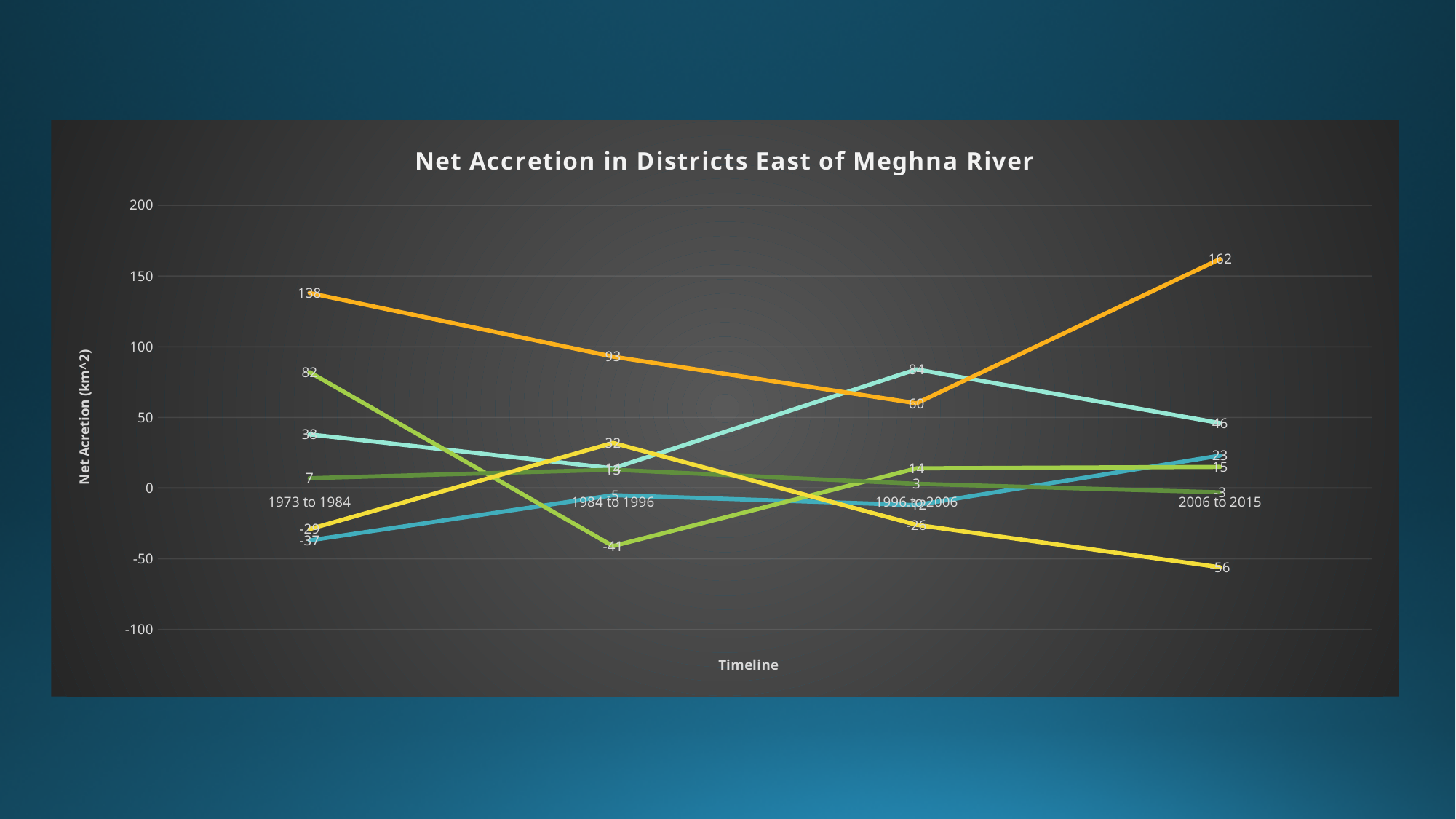
What is the value of the yellow line for 2006 to 2015? -56 In which period does the orange line reach its lowest value? 1996 to 2006 For 2006 to 2015, which is larger: the orange line or the light cyan line? the orange line What is the value of the orange line for 1973 to 1984? 138 What is the value of the orange line for 2006 to 2015? 162 What is the value of the orange line for 1984 to 1996? 93 What is the value of the light cyan line for 1996 to 2006? 84 What is the title of the chart? Net Accretion in Districts East of Meghna River What kind of chart is shown on the slide? line chart How many time periods are shown on the x axis? 4 In which period does the orange line reach its highest value? 2006 to 2015 What is the difference between the orange line's values for 2006 to 2015 and 1996 to 2006? 102